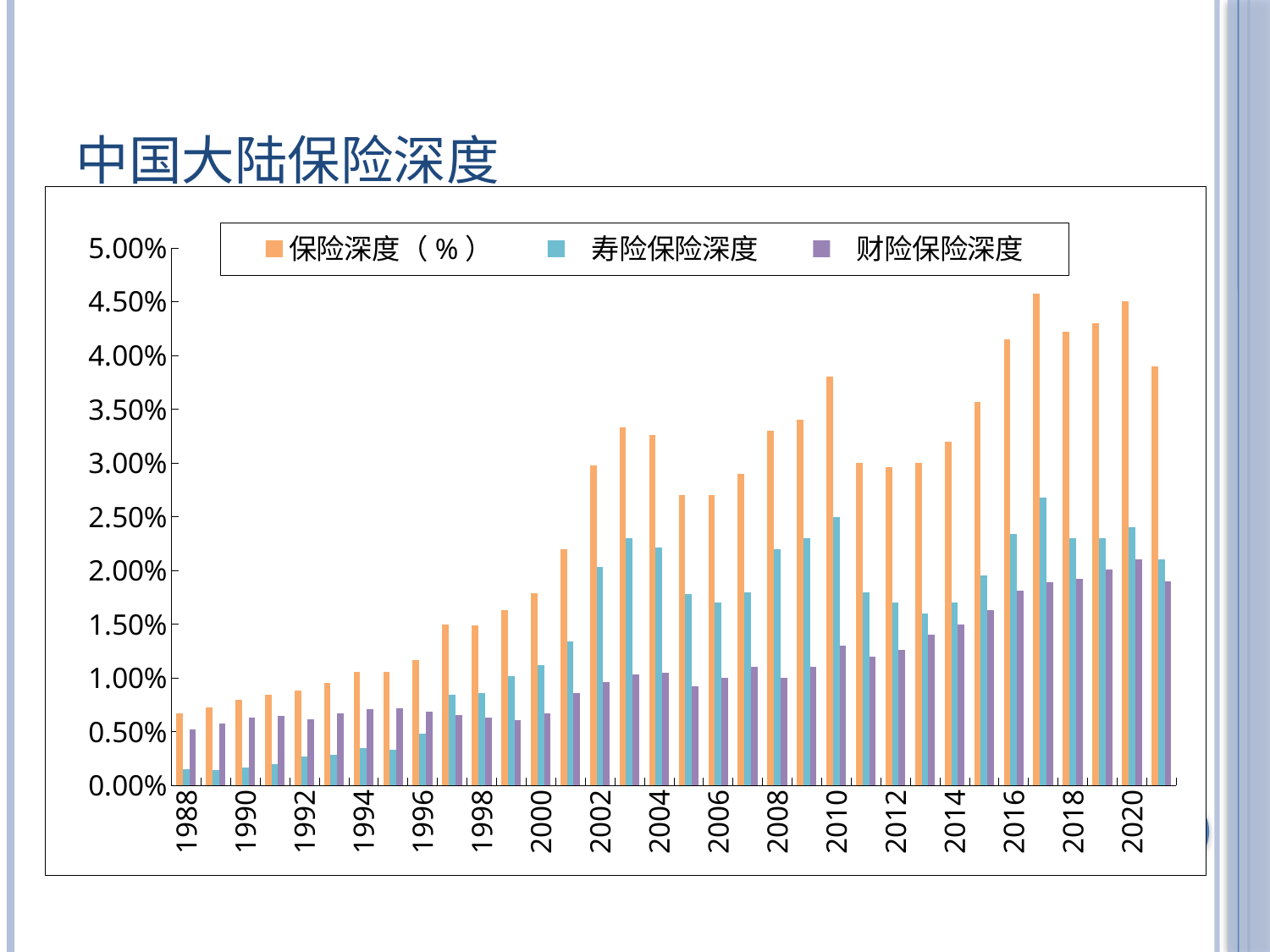
What is the title of the slide's chart? 中国大陆保险深度 In which year is 保险深度（%） highest? 2017 In which year is 寿险保险深度 highest? 2017 How many series does the legend list? 3 Which is larger in 2010, 寿险保险深度 or 财险保险深度? 寿险保险深度 Is the value of 保险深度（%） for 2000 greater or less than 2.00%? less Which colour represents 保险深度（%） in the legend? Orange Overall, does 保险深度（%） rise or fall from 1988 to 2021? Rise In which year is 保险深度（%） lowest? 1988 Is the value of 财险保险深度 for 2000 greater or less than 1.00%? less Is the value of 保险深度（%） for 2010 greater or less than 3.50%? greater What kind of chart is shown on the slide? Bar chart